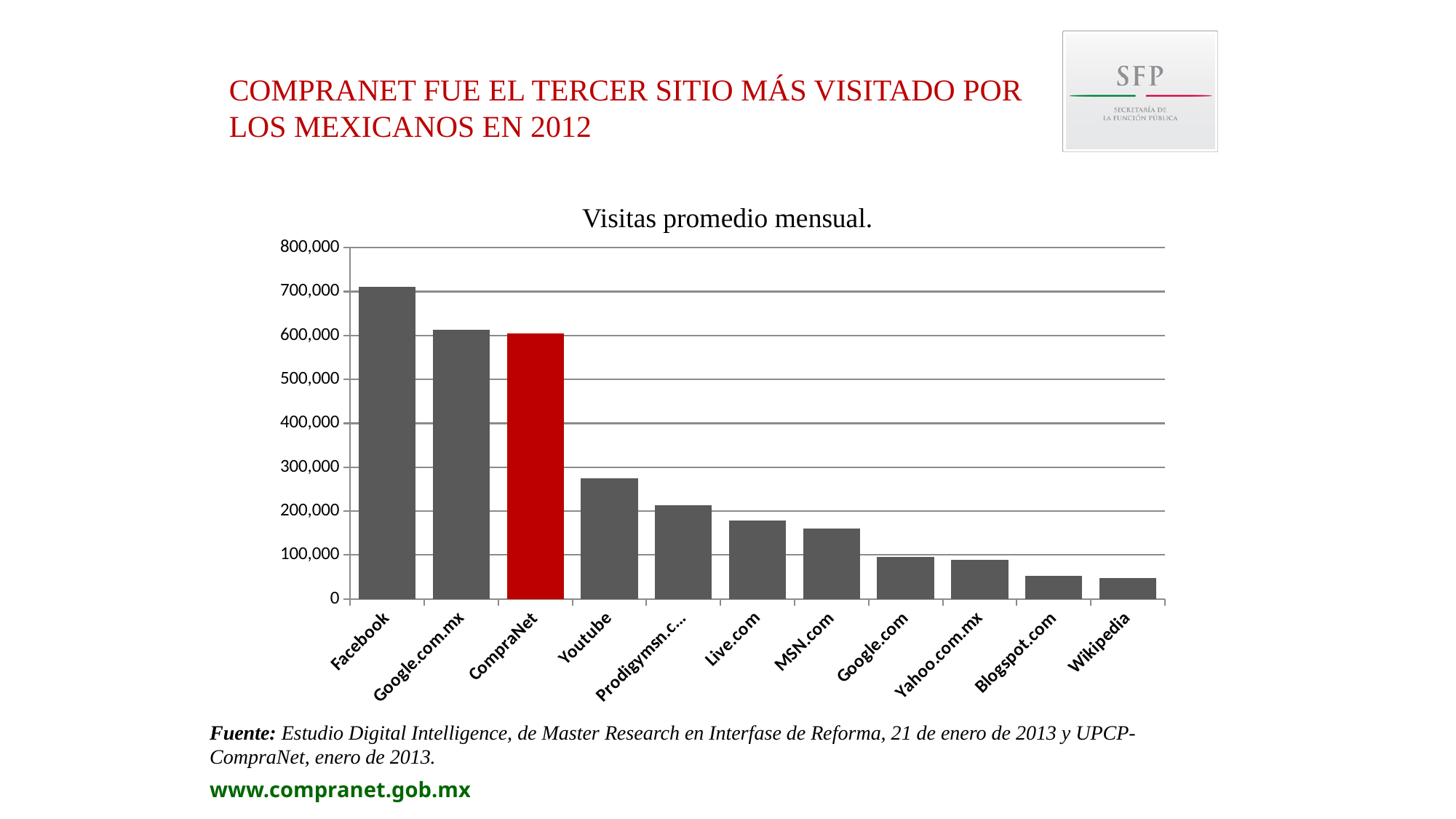
What is the title of the chart? Visitas promedio mensual. Which has more average monthly visits, Facebook or Google.com.mx? Facebook Is the value for CompraNet greater or less than 500,000? greater How many sites are shown on the x axis of the chart? 11 Which site has the highest average monthly visits in the chart? Facebook Is the value for Facebook greater or less than 600,000? greater Is the value for Live.com greater or less than 200,000? less What kind of chart is shown on the slide? Bar chart Do the values rise or fall moving from left to right along the x axis? Fall Which bar is coloured red in the chart? CompraNet